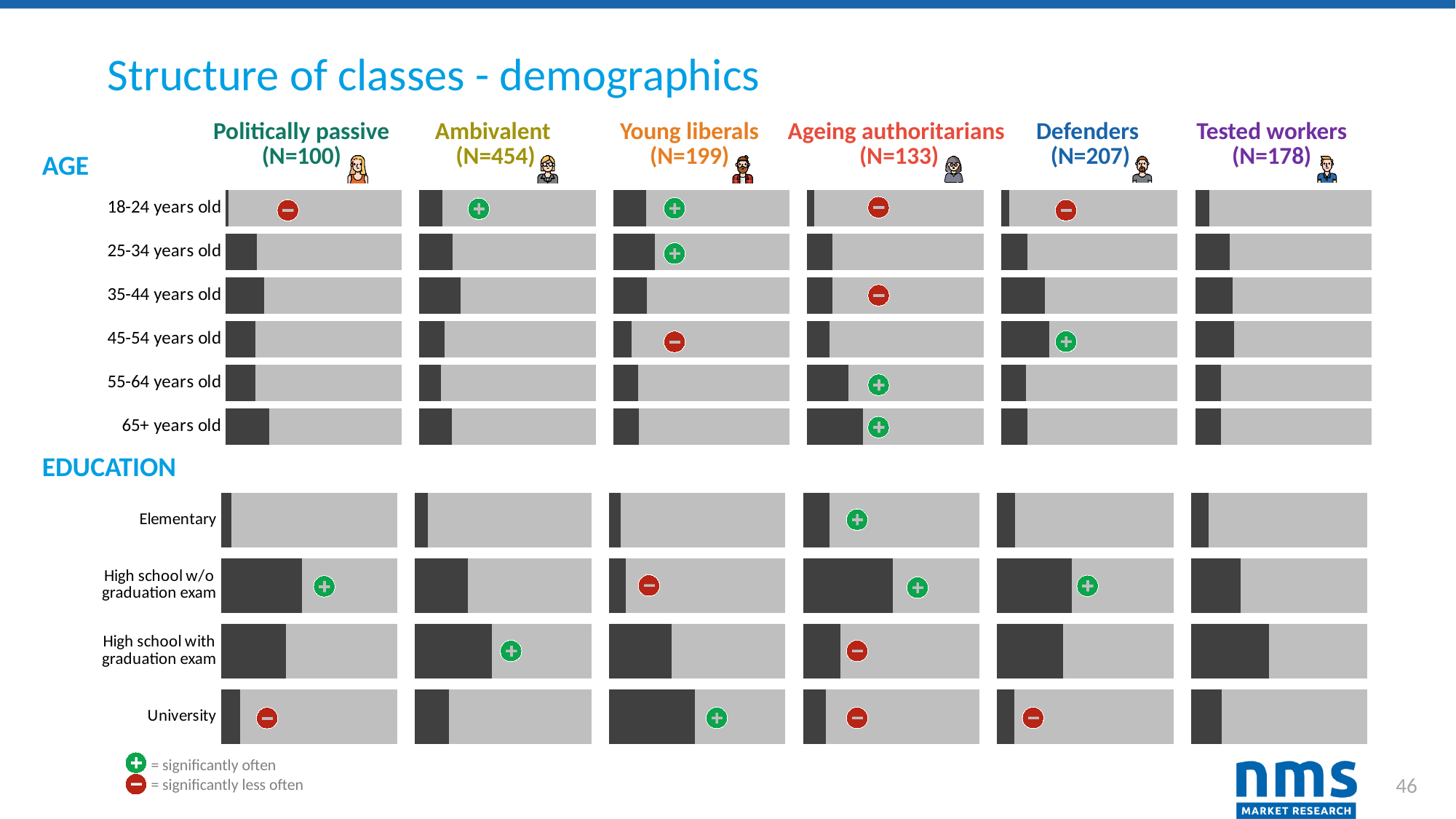
How many classes (columns) are compared on the slide? 6 What kind of chart is used to show the age and education structure of the classes? bar chart In the Ageing authoritarians column, which age category has the smallest bar? 18-24 years old How many age categories are shown in the AGE section? 6 In the Young liberals column, which education category has the largest bar? University Which is larger: the University bar for Young liberals or the University bar for Politically passive? Young liberals In the Ageing authoritarians column, which age category has the largest bar? 65+ years old In the Ageing authoritarians column, which education category has the largest bar? High school w/o graduation exam According to the legend, what does the green plus symbol mean? significantly often How many education categories are shown in the EDUCATION section? 4 What is the sample size (N) of the Ambivalent class? N=454